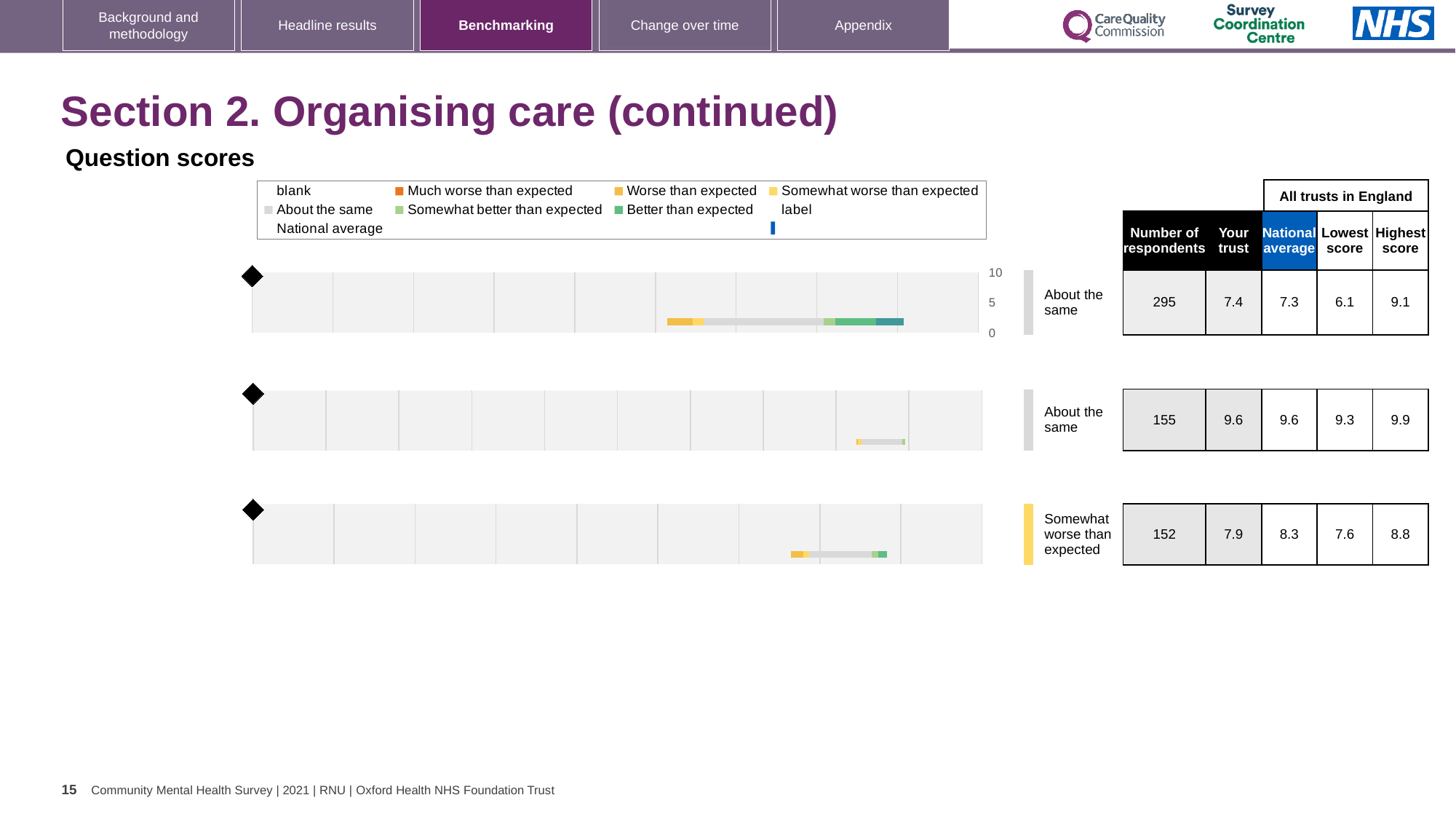
For the top chart, what is the 'Your trust' score? 7.4 For the bottom chart, which is larger: the 'Your trust' score or the national average? National average How many question score charts are shown on the slide? 3 For the middle chart, what is the 'Your trust' score? 9.6 For the top chart, what is the national average score? 7.3 What is the maximum value shown on the axis of the top chart? 10 For the middle chart, what is the lowest score among all trusts in England? 9.3 For the bottom chart, what benchmark category label is shown next to the chart? Somewhat worse than expected For the top chart, what is the number of respondents shown in the table? 295 For the top chart, what is the difference between the highest score and the lowest score? 3.0 What kind of chart is used to show the question scores on this slide? bar chart Which chart has the highest number of respondents? The top chart